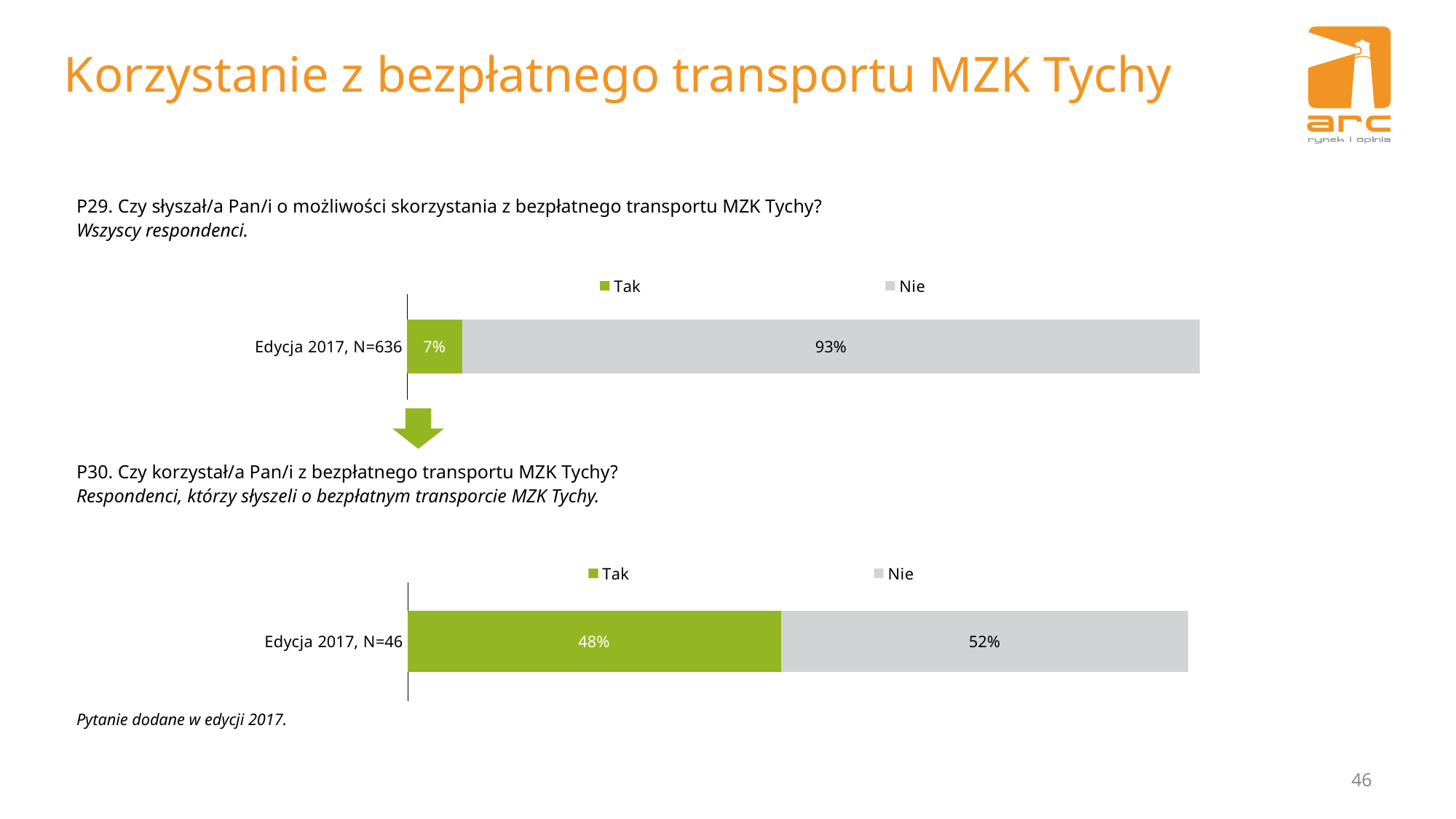
In the bottom chart (P30), what is the value for Nie? 52% What is the category label of the bar in the bottom chart (P30)? Edycja 2017, N=46 In the top chart (P29), what is the difference between the Nie and Tak values? 86 percentage points In the bottom chart (P30), which series has the lower value, Tak or Nie? Tak In the top chart (P29), what is the value for Nie? 93% In the bottom chart (P30), what is the difference between the Nie and Tak values? 4 percentage points What kind of chart is the top chart (P29)? Stacked bar chart How many series does the legend of the bottom chart (P30) list? 2 In the top chart (P29), what is the value for Tak? 7% In the top chart (P29), what is the total of the stacked bar for Edycja 2017, N=636? 100% In the top chart (P29), which series has the higher value, Tak or Nie? Nie In the bottom chart (P30), what is the value for Tak? 48%